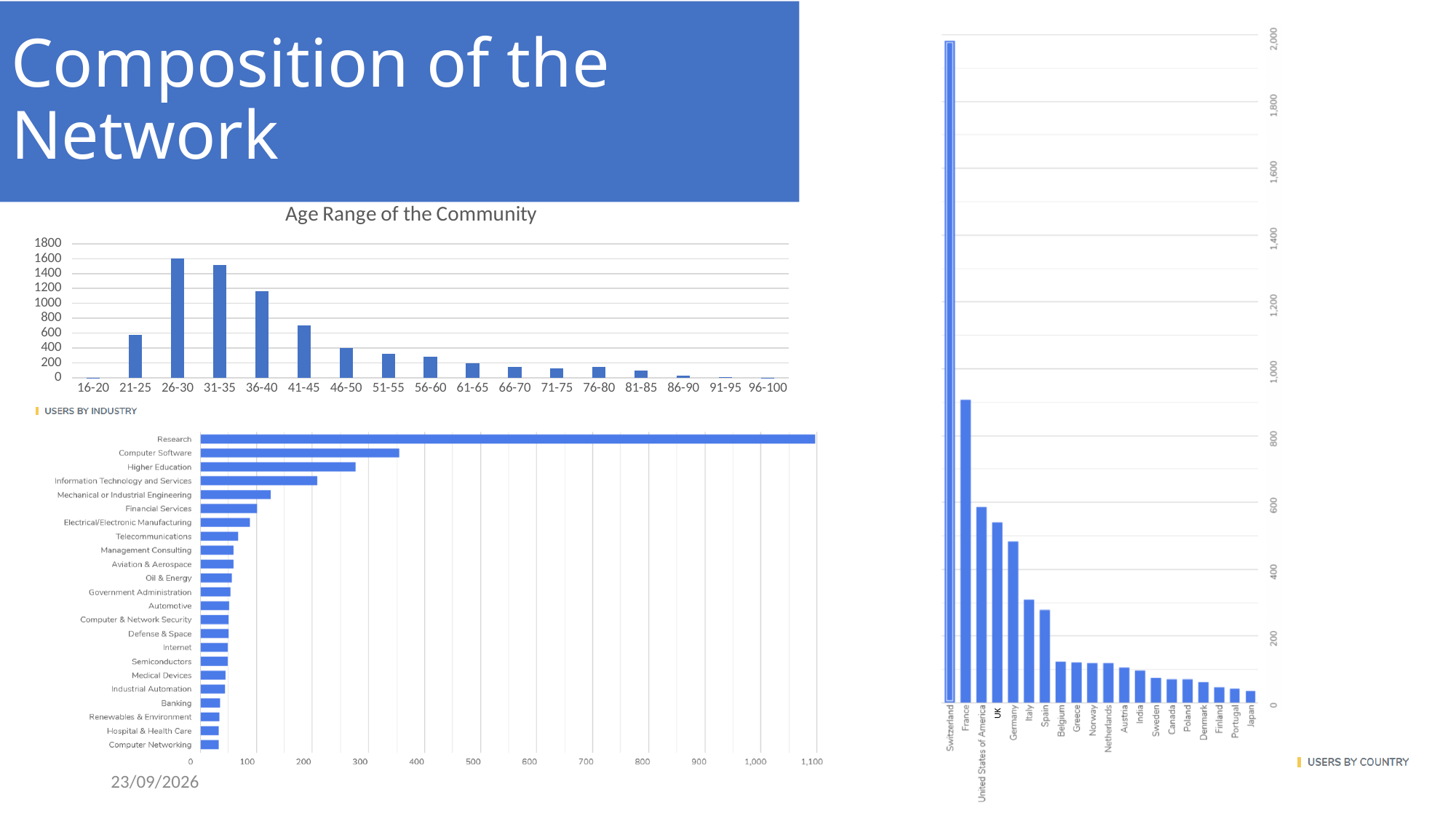
In the "Age Range of the Community" chart, is the value for 41-45 greater or less than 800? less In the "USERS BY INDUSTRY" chart, which industry has the highest value? Research In the "Age Range of the Community" chart, how many age ranges are shown on the x axis? 17 In the "Age Range of the Community" chart, do the values rise or fall from 26-30 to 96-100? fall In the "USERS BY INDUSTRY" chart, is the value for Research greater or less than 1,000? greater In the "USERS BY COUNTRY" chart, which is larger, Italy or Spain? Italy In the "USERS BY INDUSTRY" chart, which is larger, Computer Software or Higher Education? Computer Software In the "USERS BY COUNTRY" chart, is the value for France greater or less than 800? greater In the "USERS BY COUNTRY" chart, which country has the highest value? Switzerland In the "Age Range of the Community" chart, which age range has the highest value? 26-30 What type of chart is the "Age Range of the Community" chart? bar chart